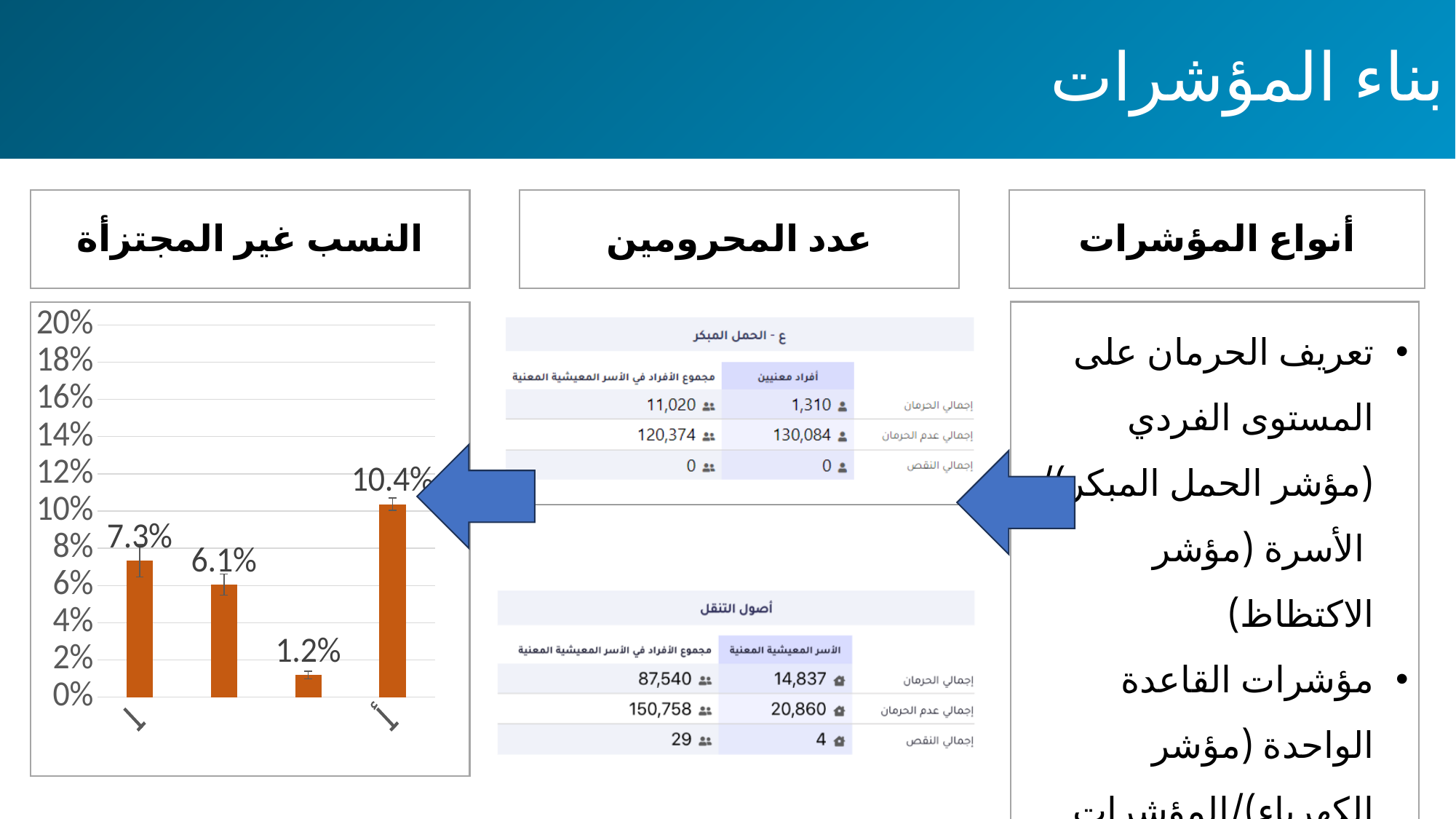
How many bars are plotted in the bar chart on the left? 4 What type of chart is shown on the left of the slide? bar chart Which bar in the bar chart has the highest value? the fourth (rightmost) bar, 10.4% Which bar in the bar chart has the lowest value? the third bar, 1.2% What is the value shown on the second bar from the left in the bar chart? 6.1% Which is larger in the bar chart: the first bar or the second bar? the first bar (7.3%) What is the value shown on the third bar from the left in the bar chart? 1.2% What is the difference between the highest bar (10.4%) and the lowest bar (1.2%) in the bar chart? 9.2% What is the value shown on the fourth (rightmost) bar of the bar chart? 10.4% What colour are the bars in the bar chart? orange What is the value shown on the first (leftmost) bar of the bar chart? 7.3% What is the maximum value shown on the vertical axis of the bar chart? 20%